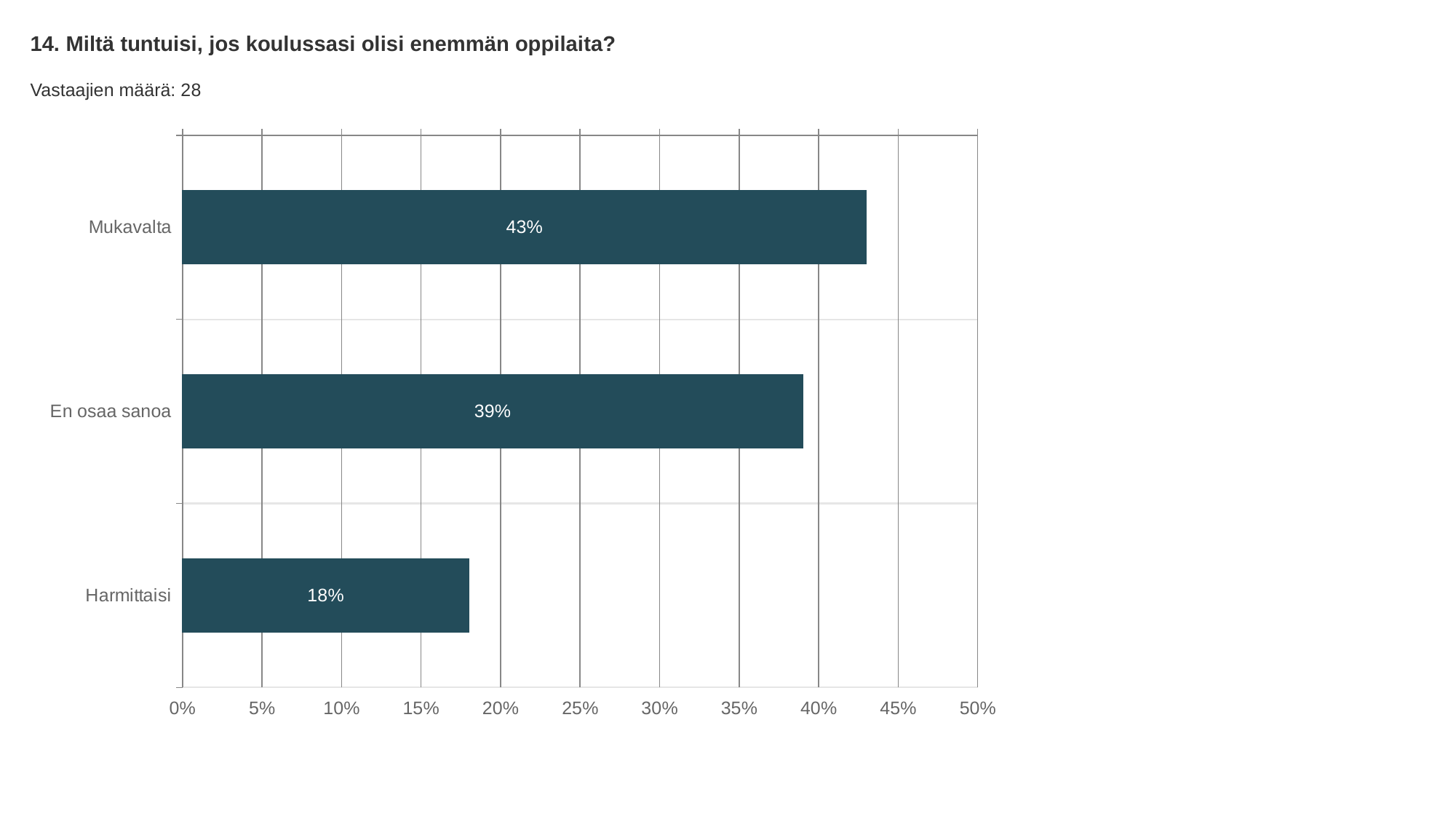
What is the difference between the values for Mukavalta and Harmittaisi? 25% How many categories are shown in the chart? 3 What is the difference between the values for Mukavalta and En osaa sanoa? 4% What is the value for Mukavalta? 43% Which is larger, the value for En osaa sanoa or the value for Harmittaisi? En osaa sanoa Is the value for Harmittaisi greater or less than 20%? less What is the value for En osaa sanoa? 39% What kind of chart is shown on the slide? bar chart What is the value for Harmittaisi? 18% Which category has the lowest value? Harmittaisi How many respondents does the slide report (Vastaajien määrä)? 28 Which category has the highest value? Mukavalta